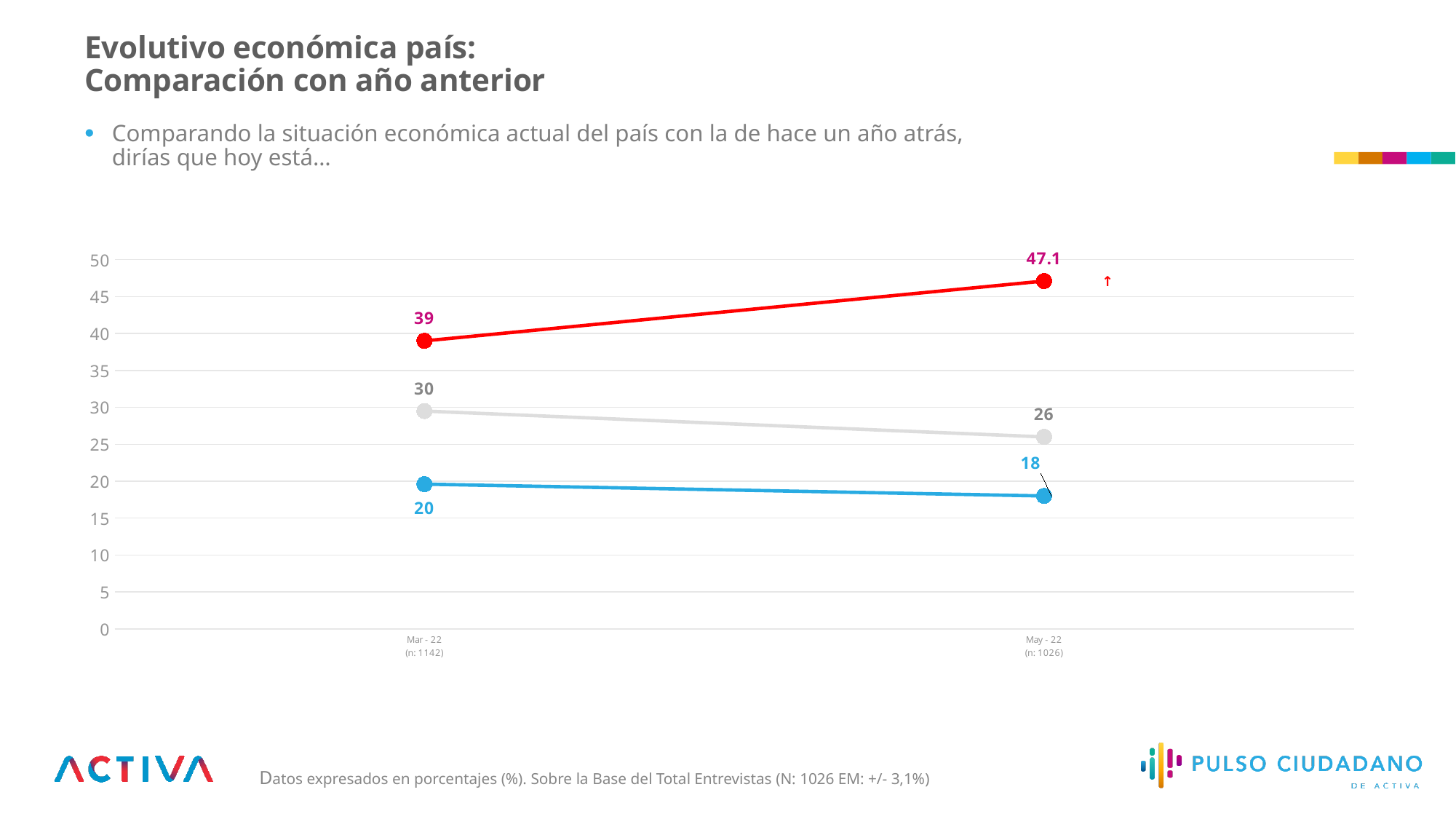
What is the value of the red line at May - 22? 47.1 What is the value of the red line at Mar - 22? 39 What is the value of the grey line at May - 22? 26 By how much did the grey line change from Mar - 22 to May - 22? 4 Which line has the lowest value at Mar - 22? the blue line Which line has the highest value at May - 22? the red line Does the red line rise or fall from Mar - 22 to May - 22? rise What kind of chart is shown on the slide? line chart How many time points are shown on the x axis? 2 Is the value of the grey line at Mar - 22 larger or smaller than the value of the blue line at Mar - 22? larger What is the value of the blue line at May - 22? 18 What is the value of the blue line at Mar - 22? 20